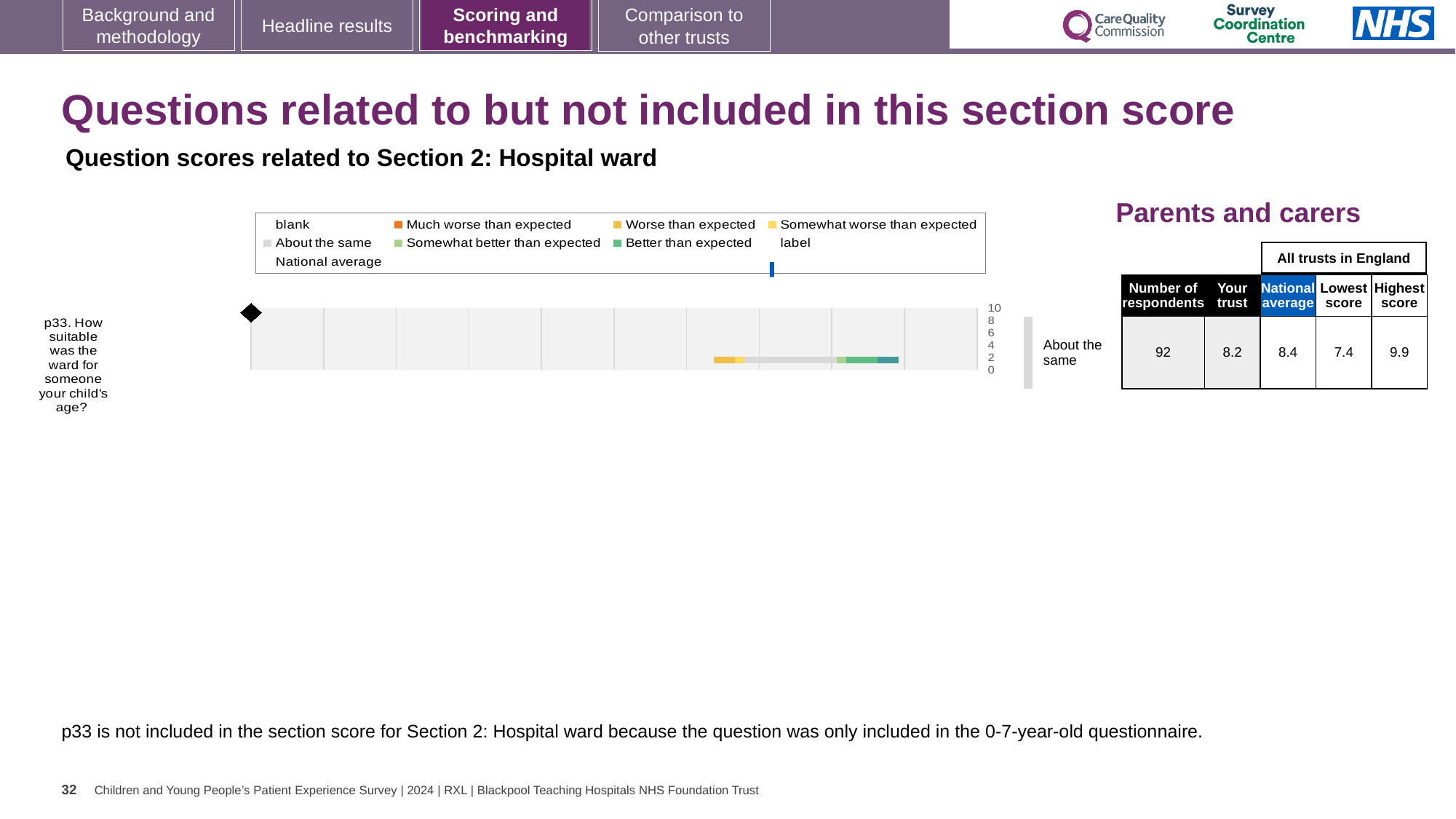
Is the 'Your trust' score for p33 higher or lower than the national average? lower What is the highest score among all trusts in England for p33? 9.9 How many questions are plotted in the chart? 1 What is the national average score for p33? 8.4 What is the difference between the national average and the 'Your trust' score for p33? 0.2 Which question is plotted in the chart? p33. How suitable was the ward for someone your child's age? What is the 'Your trust' score for p33? 8.2 What kind of chart is used to show the score for question p33? bar chart What is the difference between the highest score and the lowest score for p33? 2.5 What is the lowest score among all trusts in England for p33? 7.4 How many respondents answered p33? 92 What category label is shown to the right of the bar for p33? About the same